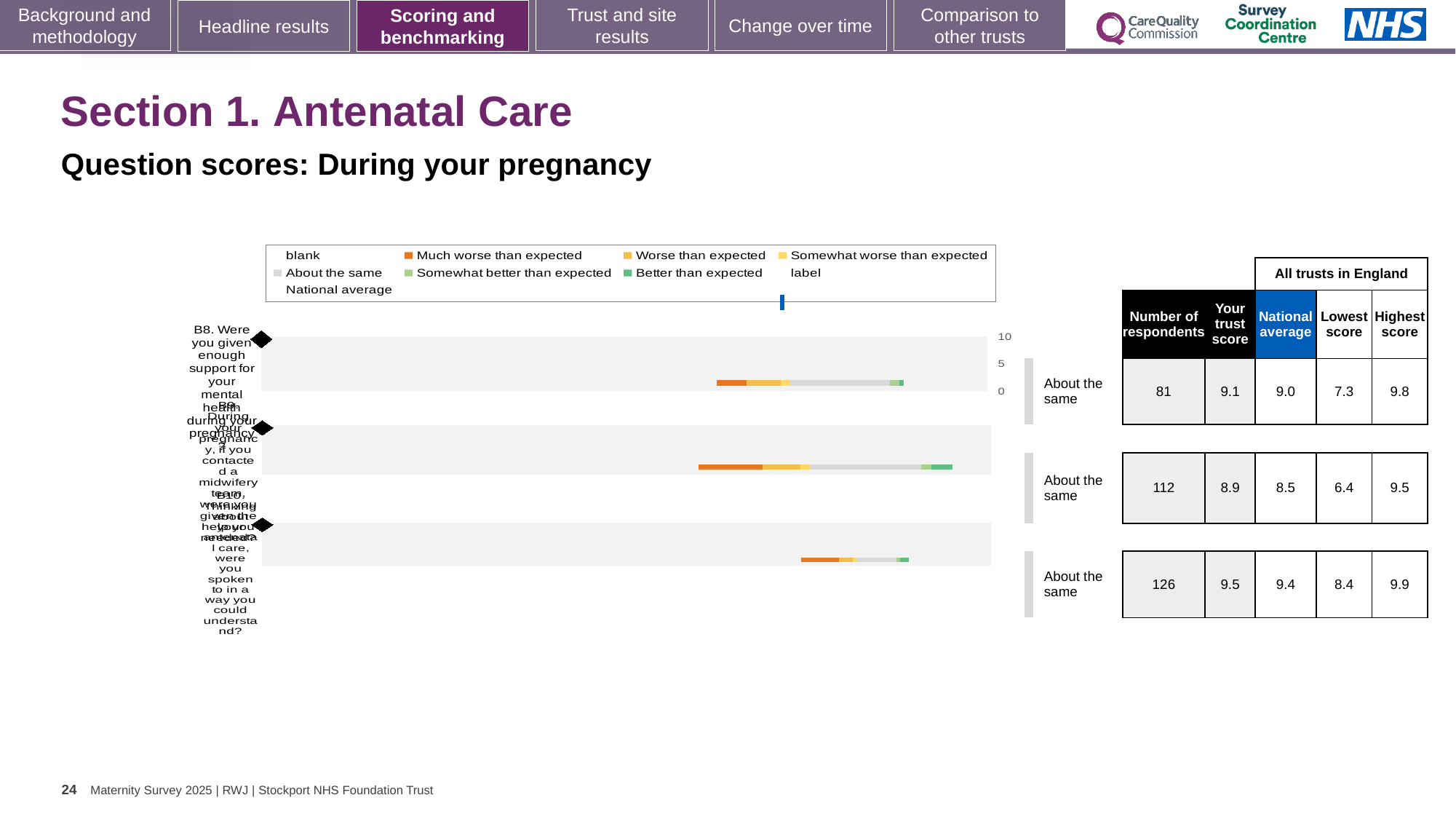
What is the lowest score among all trusts in England for question B8? 7.3 What is the national average for the second question row in the chart? 8.5 What is the difference between the trust score and the national average for the second question row? 0.4 Which question row has the lowest trust score? the second row (8.9) What is the highest score among all trusts in England for the third question row? 9.9 How many respondents answered question B8, the first row of the chart? 81 How many question rows (bars) are plotted in the chart? 3 What kind of chart is used to show the question scores on this slide? bar chart What is the trust score for question B8 (Were you given enough support for your mental health during your pregnancy?)? 9.1 Which question row has the largest number of respondents? the third row (126) Is the trust score for question B8 higher or lower than the national average? higher What benchmarking category is shown for all three question rows? About the same